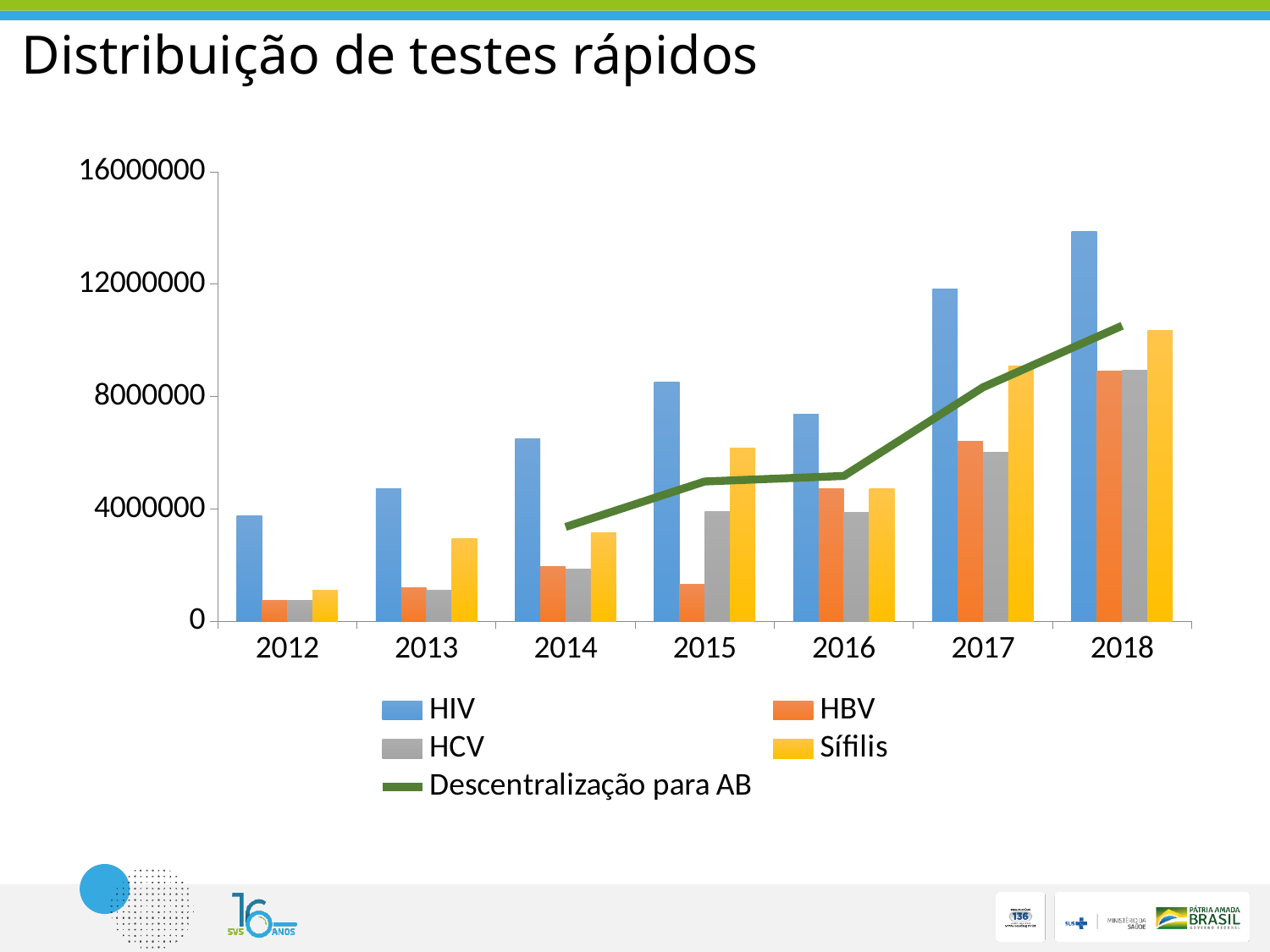
Do the Sífilis values generally rise or fall from 2012 to 2018? rise What is the name of the series plotted as a line? Descentralização para AB In which year is the HIV bar lowest? 2012 How many series does the legend list? 5 Is the HIV value for 2018 greater or less than 12000000? greater In which year is the HIV bar highest? 2018 How many years are shown on the x axis? 7 In 2017, which is larger: HIV or Sífilis? HIV Is the Sífilis value for 2018 greater or less than 8000000? greater What kind of chart is shown on the slide? bar chart (with a line series) In 2015, which is larger: Sífilis or HBV? Sífilis Is the HIV value for 2012 greater or less than 4000000? less